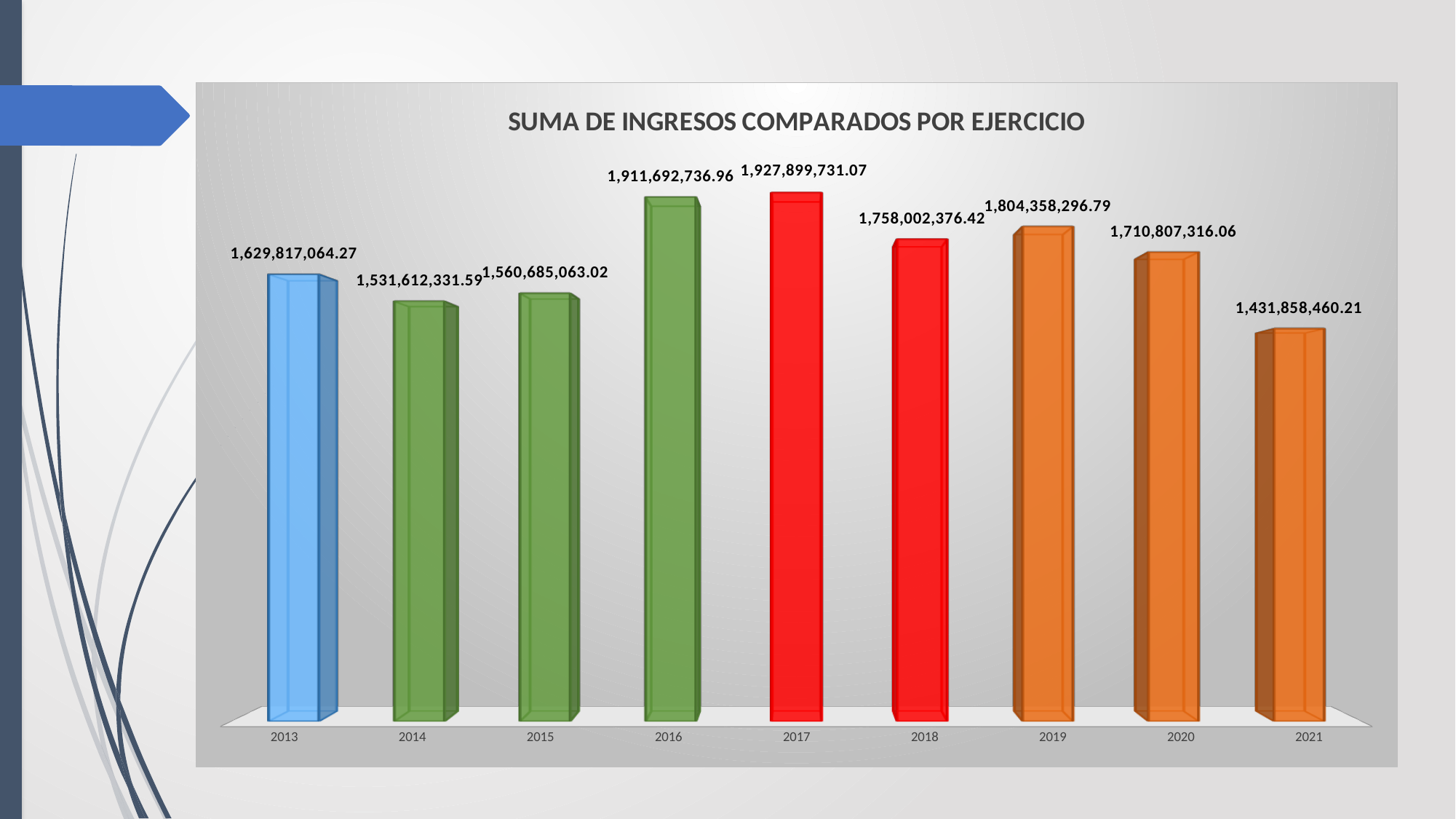
What is the value for 2017? 1,927,899,731.07 What is the difference between the values for 2013 and 2021? 197,958,604.06 What is the value for 2019? 1,804,358,296.79 What kind of chart is this? bar chart Do the values rise or fall from 2019 to 2021? fall What is the difference between the values for 2017 and 2016? 16,206,994.11 Which year has the highest value? 2017 What is the value for 2021? 1,431,858,460.21 How many years are shown on the x axis? 9 Which year has the lowest value? 2021 Which is larger, the value for 2018 or the value for 2019? 2019 What is the value for 2013? 1,629,817,064.27